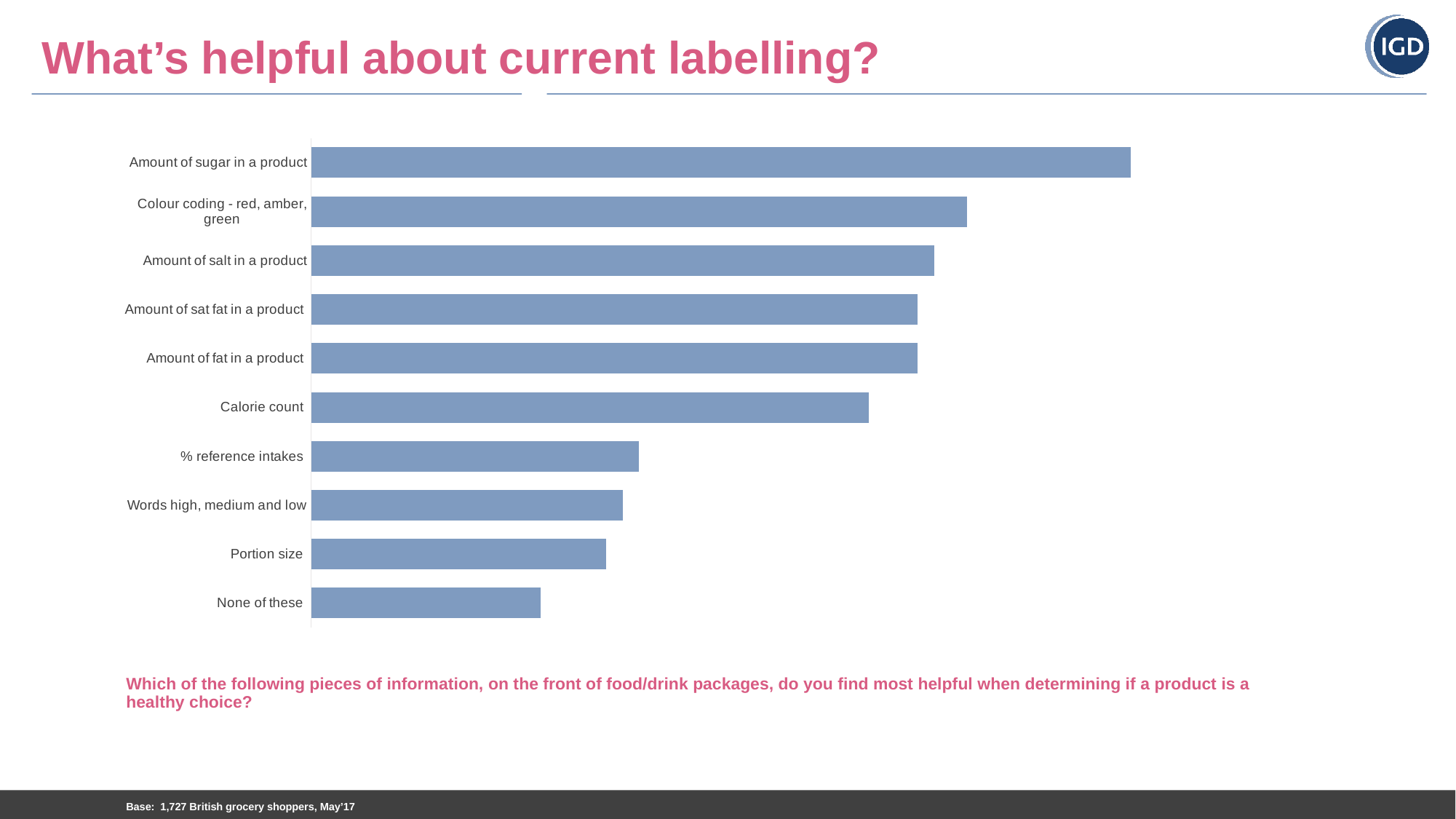
Which has the larger value: Words high, medium and low or Amount of fat in a product? Amount of fat in a product How many categories are plotted in the chart? 10 What kind of chart is shown on the slide? bar chart Which has the larger value: Portion size or None of these? Portion size Which has the larger value: Amount of sugar in a product or Colour coding - red, amber, green? Amount of sugar in a product Do the bar lengths generally increase or decrease going from the top category to the bottom category? decrease What is the title of the slide containing the chart? What's helpful about current labelling? Which category has the shortest bar in the chart? None of these What colour are the bars in the chart? blue Which category has the longest bar in the chart? Amount of sugar in a product